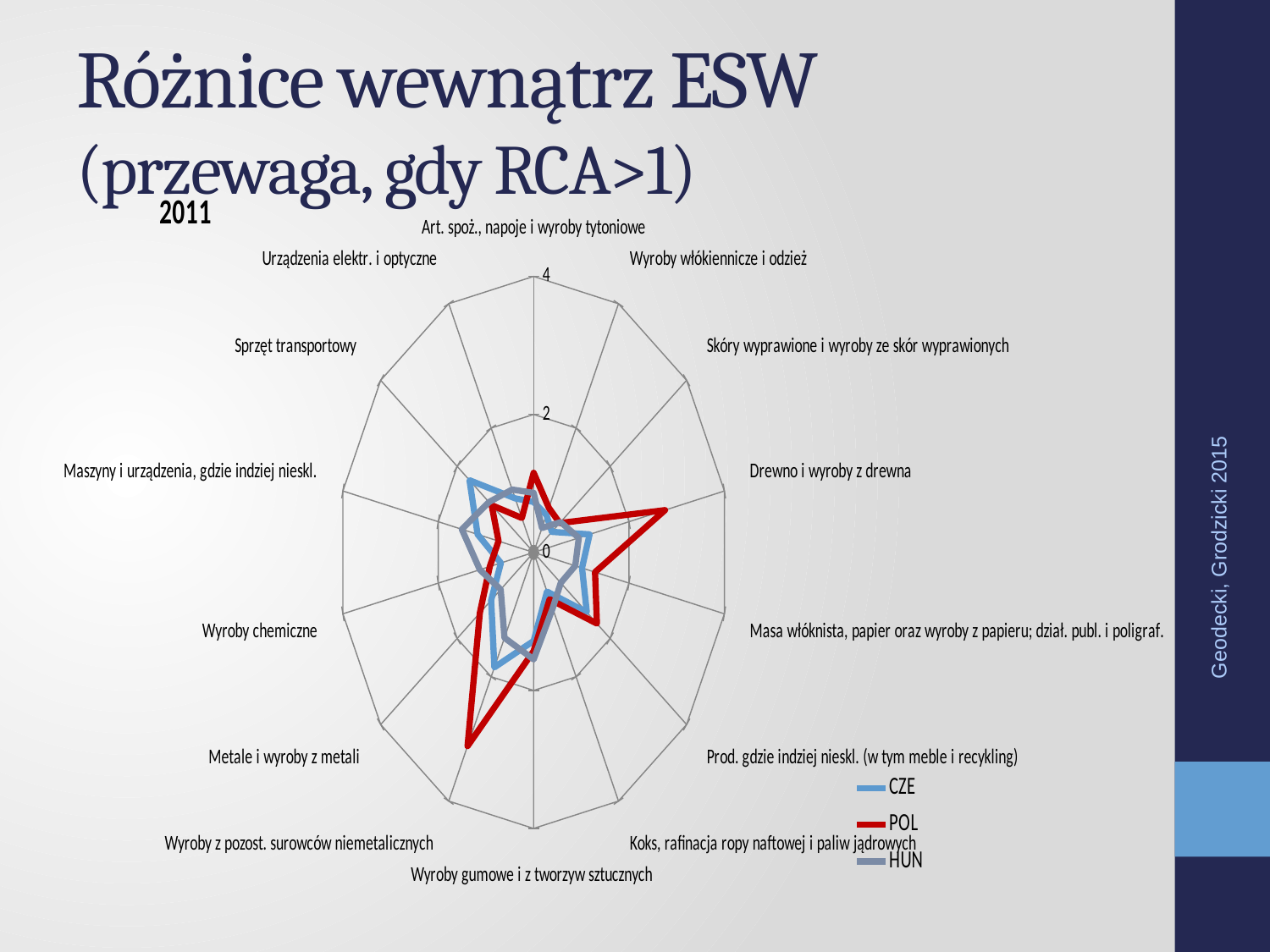
Which series are listed in the legend? CZE, POL, HUN Is the CZE value for Art. spoż., napoje i wyroby tytoniowe greater or less than 2? less How many categories (axes) does the radar chart have? 14 What is the highest value shown on the chart's axis scale? 4 Which series has the highest value for Wyroby z pozost. surowców niemetalicznych? POL What kind of chart is shown on the slide? radar chart How many series does the legend list? 3 For Wyroby z pozost. surowców niemetalicznych, which is larger: the POL value or the CZE value? POL Is the POL value for Wyroby z pozost. surowców niemetalicznych greater or less than 2? greater Is the HUN value for Urządzenia elektr. i optyczne greater or less than 2? less For Sprzęt transportowy, which is larger: the CZE value or the POL value? CZE